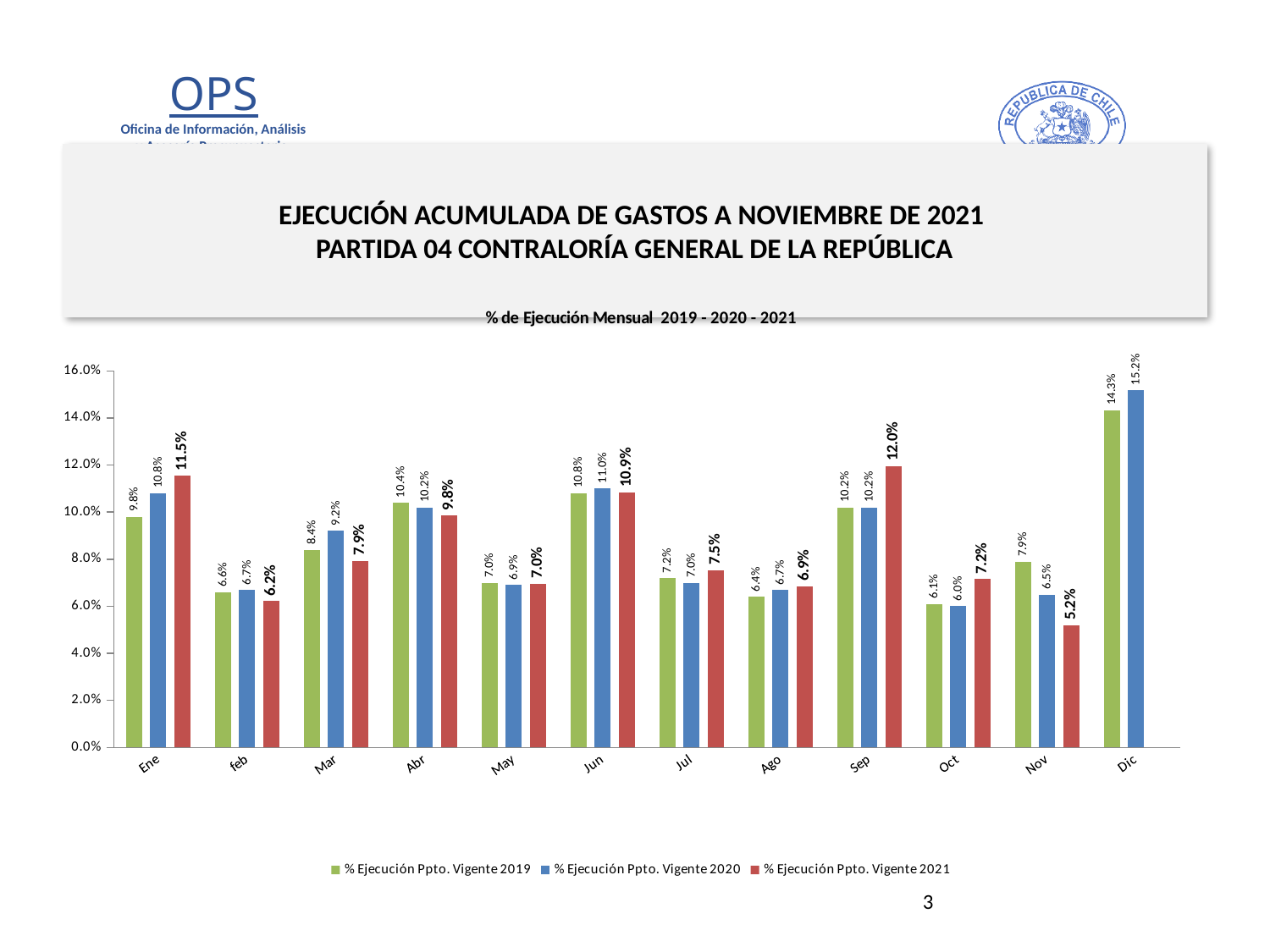
What is the value for % Ejecución Ppto. Vigente 2020 in Jun? 11.0% What is the value for % Ejecución Ppto. Vigente 2019 in Dic? 14.3% What is the value for % Ejecución Ppto. Vigente 2021 in Sep? 12.0% What kind of chart is shown on the slide? Bar chart What is the difference between the 2020 and 2021 values in Nov? 1.3% Which is larger in Ene: the 2019 value or the 2021 value? 2021 value Which month has the lowest value for % Ejecución Ppto. Vigente 2021? Nov How many series does the legend list? 3 Which month has the highest value for % Ejecución Ppto. Vigente 2020? Dic Which month has the highest value for % Ejecución Ppto. Vigente 2021? Sep What colour represents % Ejecución Ppto. Vigente 2021? Red How many months are shown on the x axis? 12